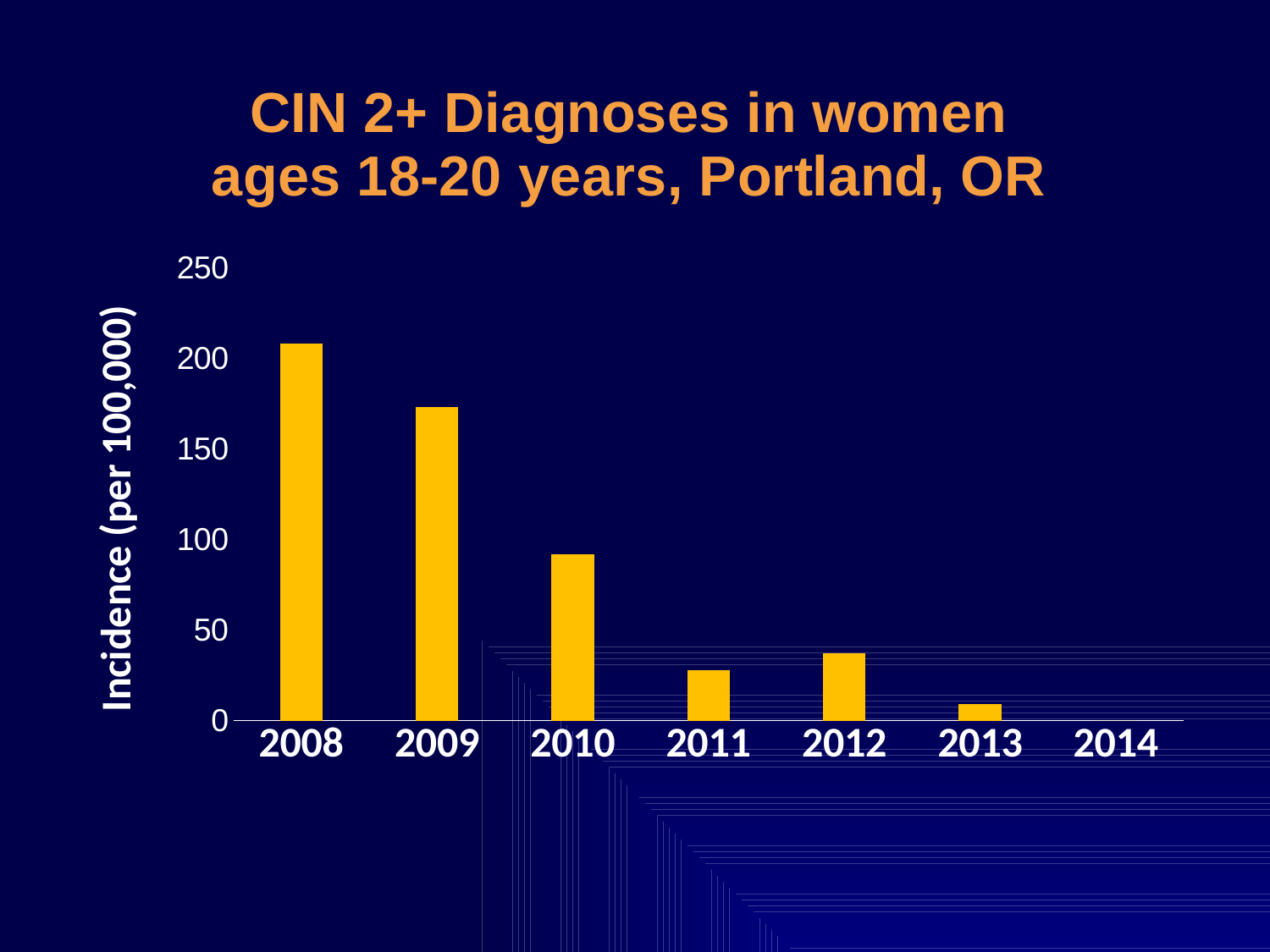
How many years are labelled on the x axis? 7 Which year has the highest incidence? 2008 Is the incidence for 2009 greater or less than 150? greater What is the label of the y axis? Incidence (per 100,000) Of the years 2008 through 2013, which has the lowest incidence? 2013 Does the incidence generally rise or fall from 2008 to 2013? fall Is the incidence for 2010 greater or less than 100? less Is the incidence for 2012 greater or less than 50? less What is the title of the chart? CIN 2+ Diagnoses in women ages 18-20 years, Portland, OR What kind of chart is shown on the slide? bar chart Which year has the higher incidence, 2011 or 2012? 2012